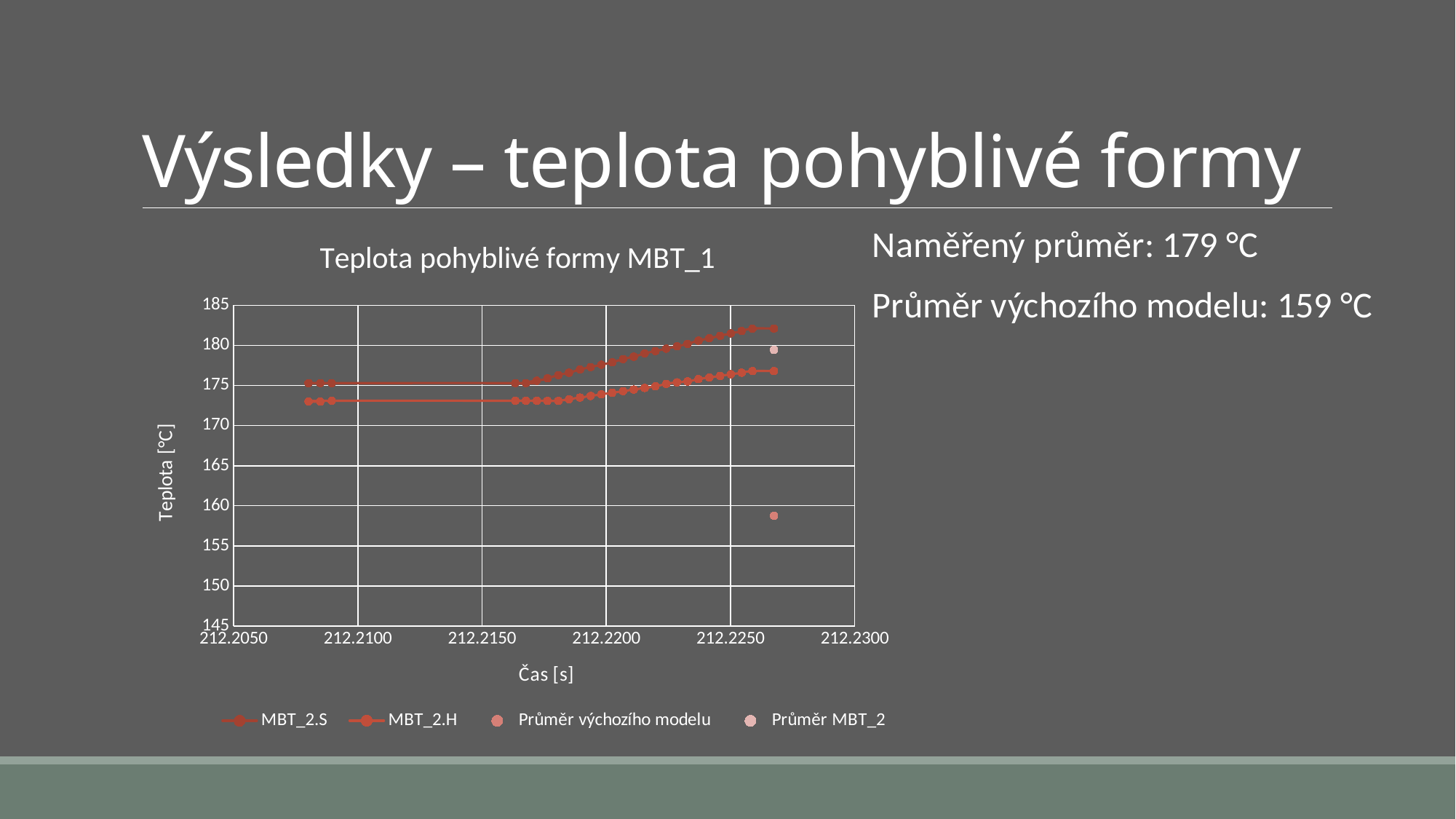
Is the value of the Průměr MBT_2 point greater or less than 175? greater What kind of chart is shown on the slide? line chart Which is higher on the chart, the Průměr MBT_2 point or the Průměr výchozího modelu point? Průměr MBT_2 Do the MBT_2.S and MBT_2.H temperature values rise or fall as time increases along the x axis? rise What is the label of the vertical axis of the chart? Teplota [°C] What is the highest value shown on the vertical axis of the chart? 185 Is the value of the Průměr výchozího modelu point greater or less than 160? less What is the title of the chart? Teplota pohyblivé formy MBT_1 Is the value of the Průměr výchozího modelu point greater or less than 155? greater How many series does the chart legend list? 4